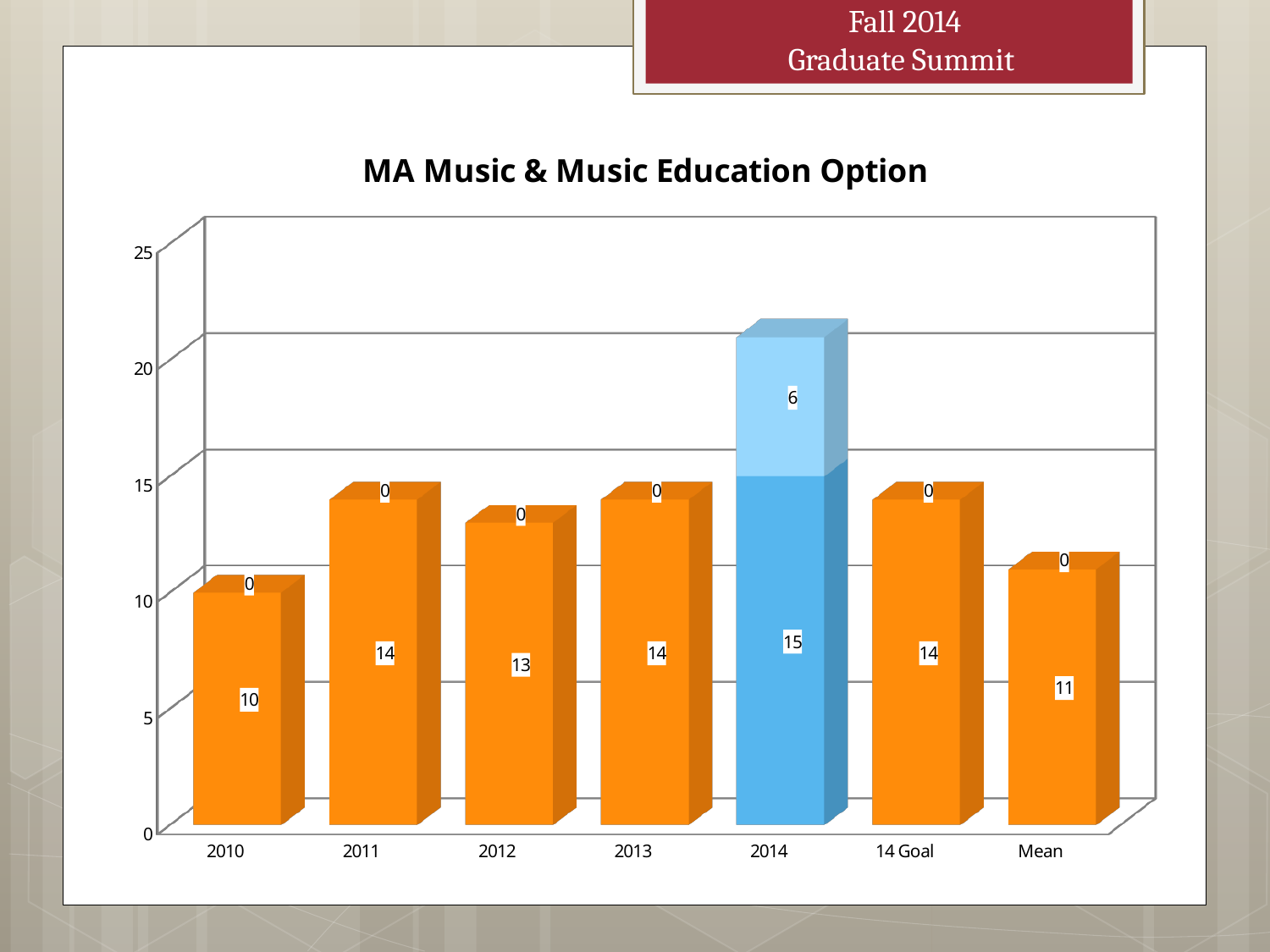
What is the value of the upper (light blue) segment for 2014? 6 Which is larger, the lower-segment value for 2011 or for 2012? 2011 What kind of chart is shown on the slide? bar chart What is the value of the lower segment for Mean? 11 What is the total of the stacked bar for 2014? 21 How many categories are shown on the x axis? 7 Is the total height of the 2014 bar greater or less than 20? greater What is the value of the lower segment for 2012? 13 What is the difference between the lower-segment values for 2014 and 14 Goal? 1 Which category has the highest lower-segment value? 2014 What is the value of the lower (orange/blue) segment for 2010? 10 Which category has the lowest lower-segment value? 2010